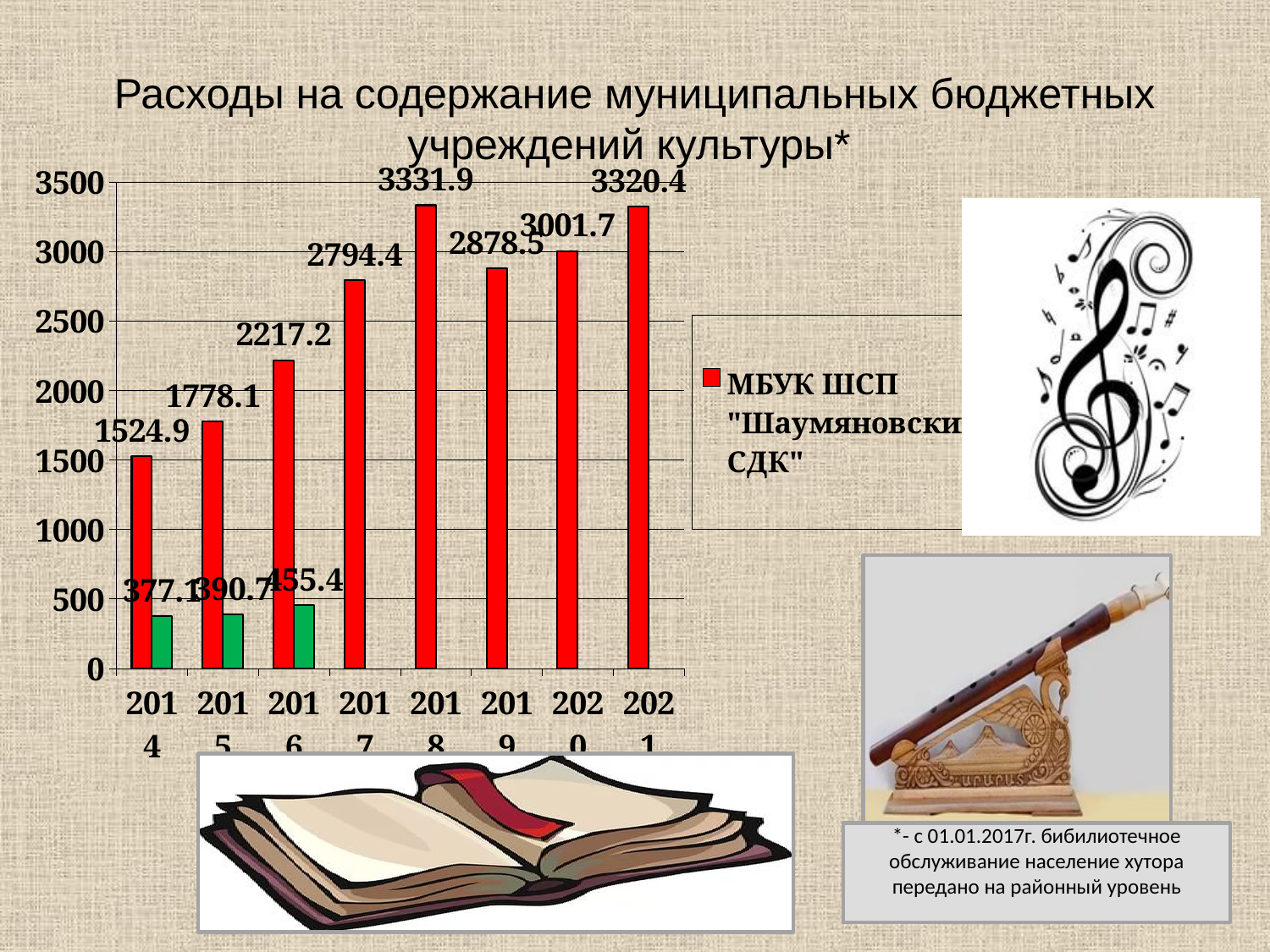
In which year is the red bar (МБУК ШСП "Шаумяновский СДК") highest? 2018 By how much does the red bar value for 2018 exceed that for 2019? 453.4 What is the value for МБУК ШСП "Шаумяновский СДК" in 2018? 3331.9 Which year has the larger red bar value, 2018 or 2021? 2018 How many years are shown on the x axis of the chart? 8 What is the difference between the red bar values for 2021 and 2020? 318.7 In which year is the red bar (МБУК ШСП "Шаумяновский СДК") lowest? 2014 What is the value of the red bar for 2014? 1524.9 Do the red bar values rise or fall from 2014 to 2018? rise What kind of chart is shown on the slide? bar chart Is the red bar value for 2017 greater or less than 2500? greater What is the value of the green bar for 2016? 455.4